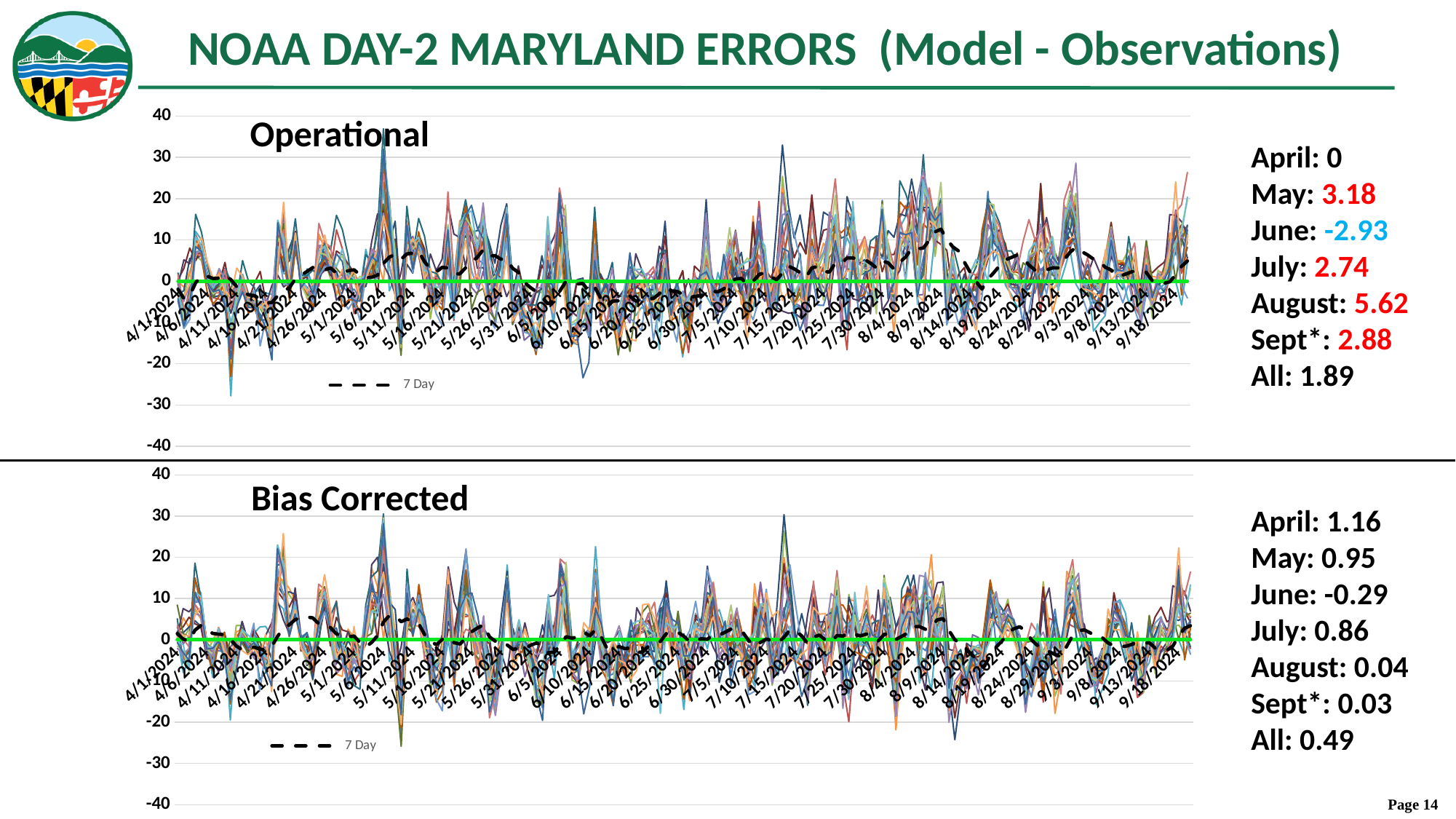
On the Operational chart, what is the August error value listed beside the chart? 5.62 On the Operational chart, what is the lowest value shown on the vertical axis? -40 What entry does the legend of the Operational chart list? 7 Day How many charts are shown on the slide? 2 Which month has the highest error value listed beside the Operational chart? August On the Operational chart, is the highest peak near 5/11/2024 greater or less than 30? greater On the Operational chart, what is the June error value listed beside the chart? -2.93 On the Bias Corrected chart, what is the 'All' error value listed beside the chart? 0.49 What is the title of the lower chart? Bias Corrected What kind of chart is the Operational chart? line chart Is the 'All' error value larger for the Operational chart or the Bias Corrected chart? Operational On the Operational chart, what is the highest value shown on the vertical axis? 40